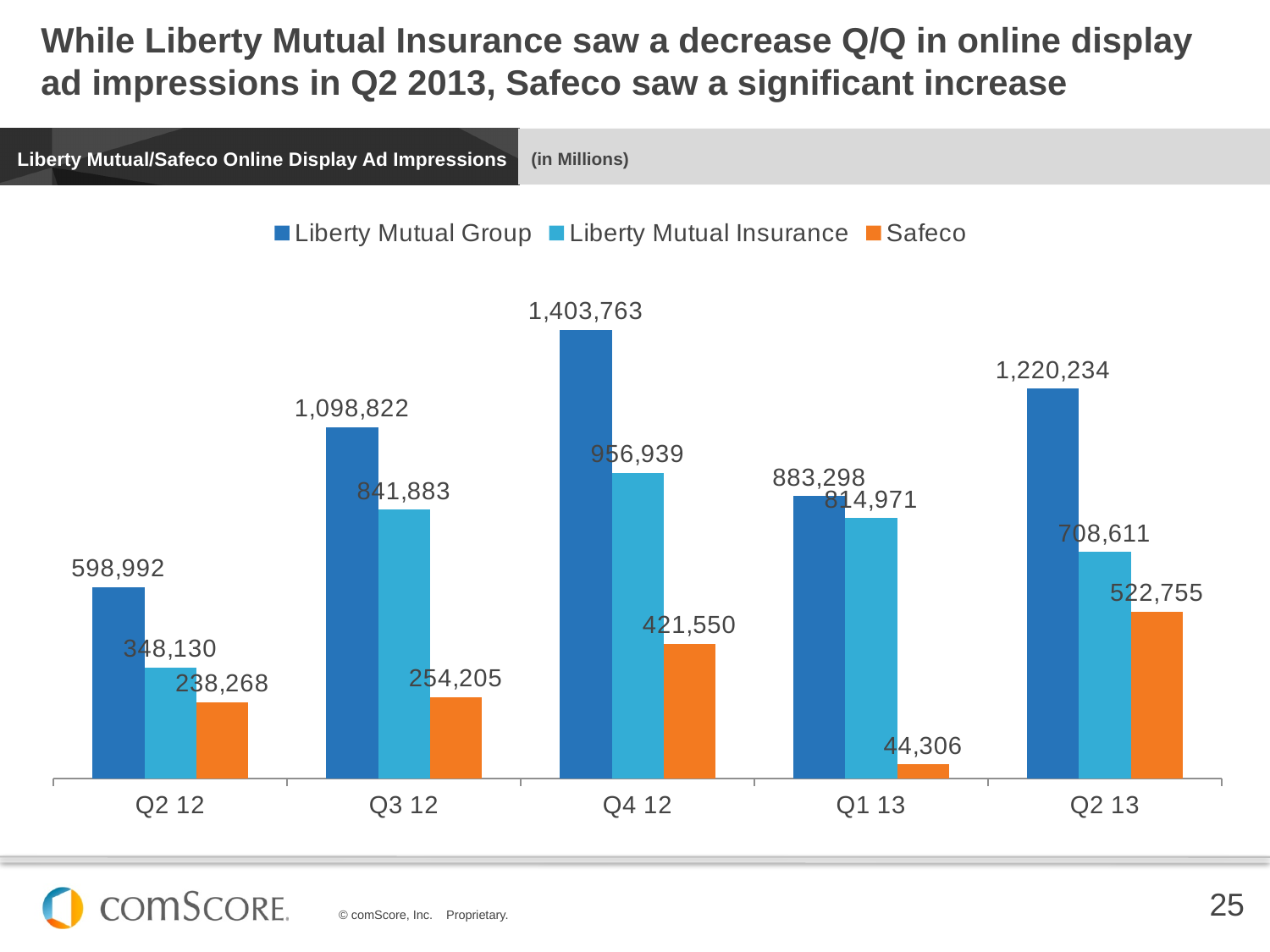
Does the Safeco value rise or fall from Q1 13 to Q2 13? Rise Which is larger for Safeco: Q4 12 or Q2 13? Q2 13 What is the value for Safeco in Q1 13? 44,306 What is the difference between the Liberty Mutual Insurance values for Q1 13 and Q2 13? 106,360 How many quarters are shown on the x axis? 5 In which quarter is the Safeco value lowest? Q1 13 How many series does the legend list? 3 What is the value for Liberty Mutual Group in Q4 12? 1,403,763 What is the difference between the Liberty Mutual Group values for Q2 13 and Q1 13? 336,936 In which quarter is the Liberty Mutual Group value highest? Q4 12 What kind of chart is shown on the slide? Bar chart What is the value for Liberty Mutual Insurance in Q2 13? 708,611